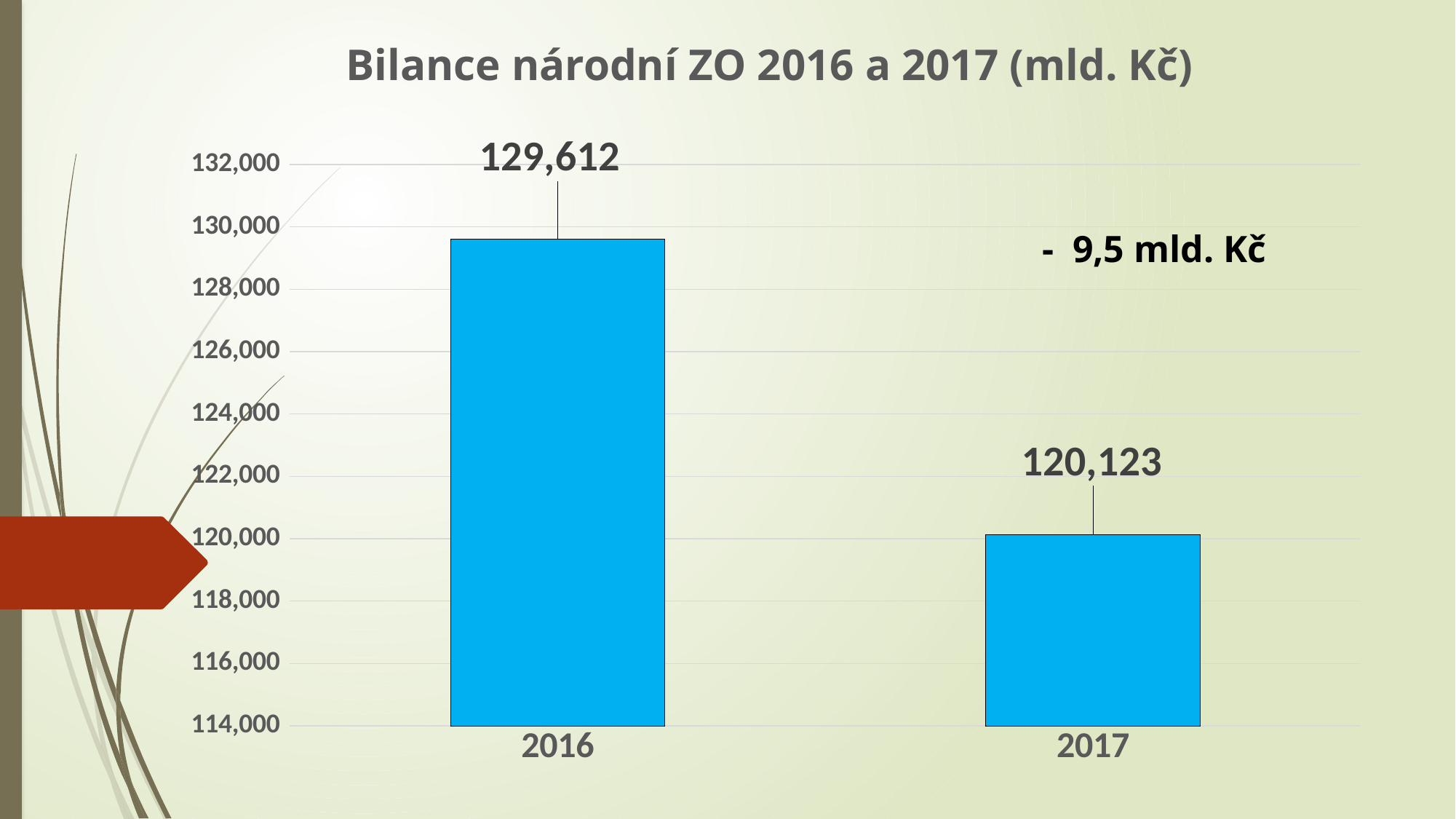
What is the value for 2017? 120,123 Is the value for 2016 greater or less than 128,000? greater How many bars are shown in the chart? 2 Do the values rise or fall from 2016 to 2017? fall What kind of chart is shown on the slide? bar chart Is the value for 2016 larger or smaller than the value for 2017? larger Which year has the lower value? 2017 What is the value for 2016? 129,612 Which year has the higher value? 2016 Is the value for 2017 greater or less than 122,000? less What is the difference between the 2016 and 2017 values? 9,489 What is the title of the chart? Bilance národní ZO 2016 a 2017 (mld. Kč)